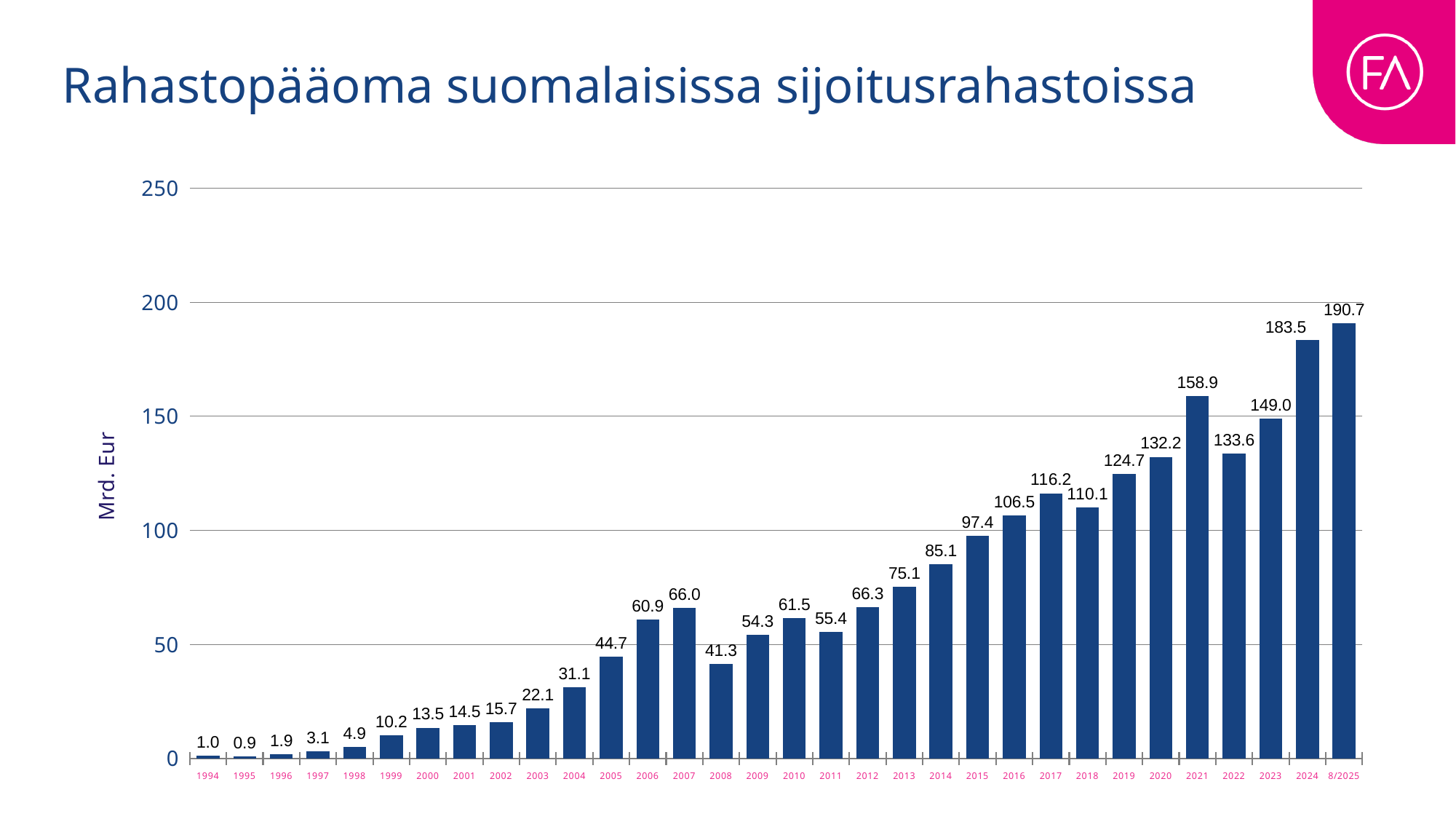
What is the value for 2008? 41.3 Is the value for 2017 greater or less than 100? greater What is the difference between the values for 2024 and 2023? 34.5 What is the value for 2021? 158.9 Do the values generally rise or fall from 1994 to 8/2025? rise What is the value for 8/2025? 190.7 Which year has the lowest value? 1995 What is the label on the vertical axis? Mrd. Eur Which category has the highest value? 8/2025 Which is larger, the value for 2022 or the value for 2020? 2022 What kind of chart is shown on the slide? bar chart How many bars are shown in the chart? 32